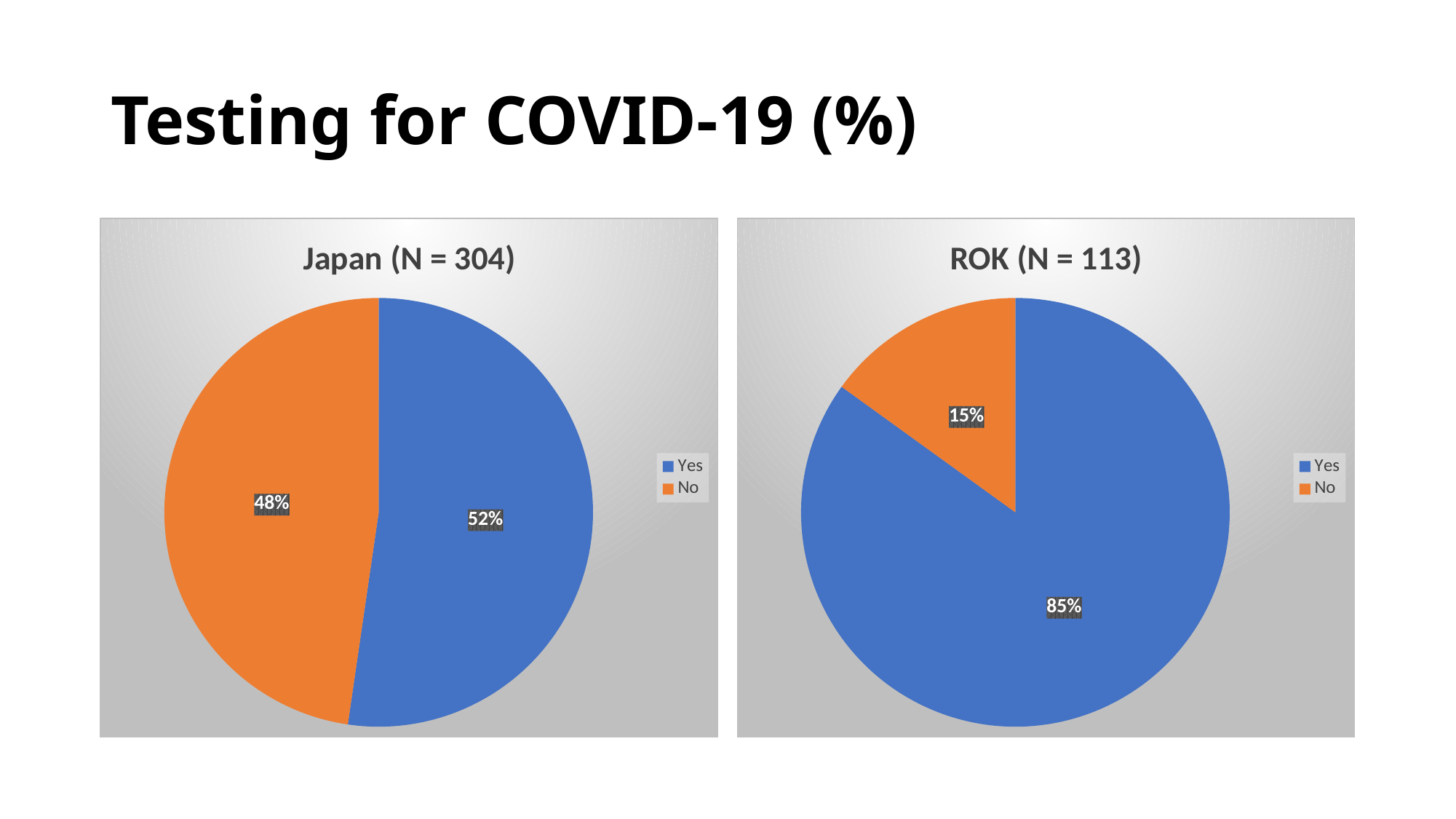
In the Japan (N = 304) chart, what share of the pie is labelled Yes? 52% In the Japan (N = 304) chart, what colour is the No slice? Orange In the ROK (N = 113) chart, what is the difference between the Yes and No shares? 70% In the ROK (N = 113) chart, which slice is the smallest? No In the Japan (N = 304) chart, which slice is larger, Yes or No? Yes In the Japan (N = 304) chart, what is the difference between the Yes and No shares? 4% In the ROK (N = 113) chart, what share of the pie is labelled No? 15% How many slices does the ROK (N = 113) pie chart have? 2 In the ROK (N = 113) chart, what share of the pie is labelled Yes? 85% In the ROK (N = 113) chart, which slice is the largest? Yes What kind of chart is the Japan (N = 304) chart? Pie chart